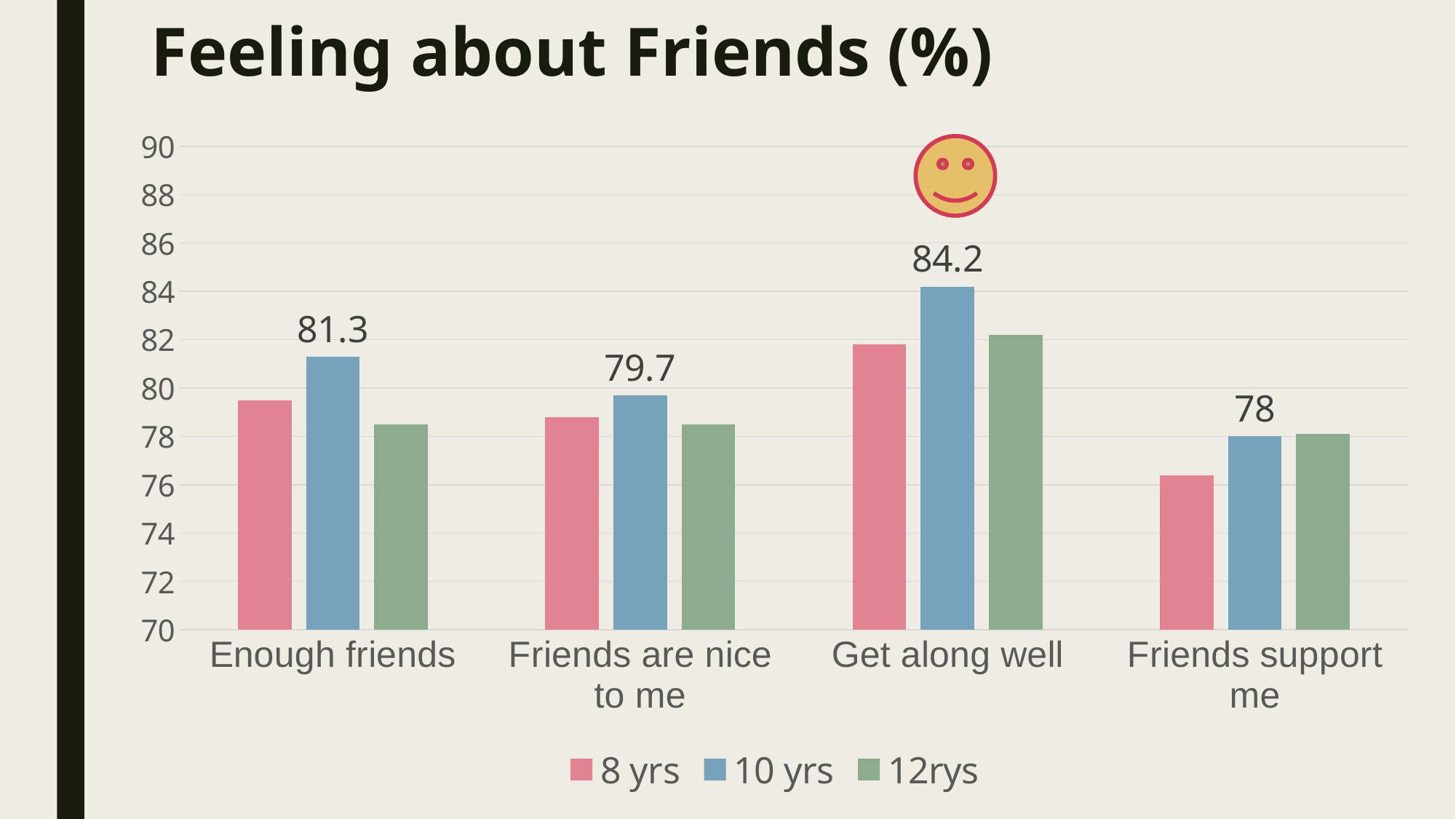
What is the value for 10 yrs in the Friends support me category? 78 How many categories are shown on the x axis? 4 What is the value for 10 yrs in the Friends are nice to me category? 79.7 Is the value for 8 yrs in the Friends support me category greater or less than 78? less For the 10 yrs series, which category has the lowest value? Friends support me How many series does the legend list? 3 What is the difference between the 10 yrs values for Get along well and Enough friends? 2.9 What kind of chart is shown on the slide? bar chart What is the value for 10 yrs in the Get along well category? 84.2 What is the value for 10 yrs in the Enough friends category? 81.3 Is the value for 12rys in the Get along well category greater or less than 80? greater For the 10 yrs series, which category has the highest value? Get along well